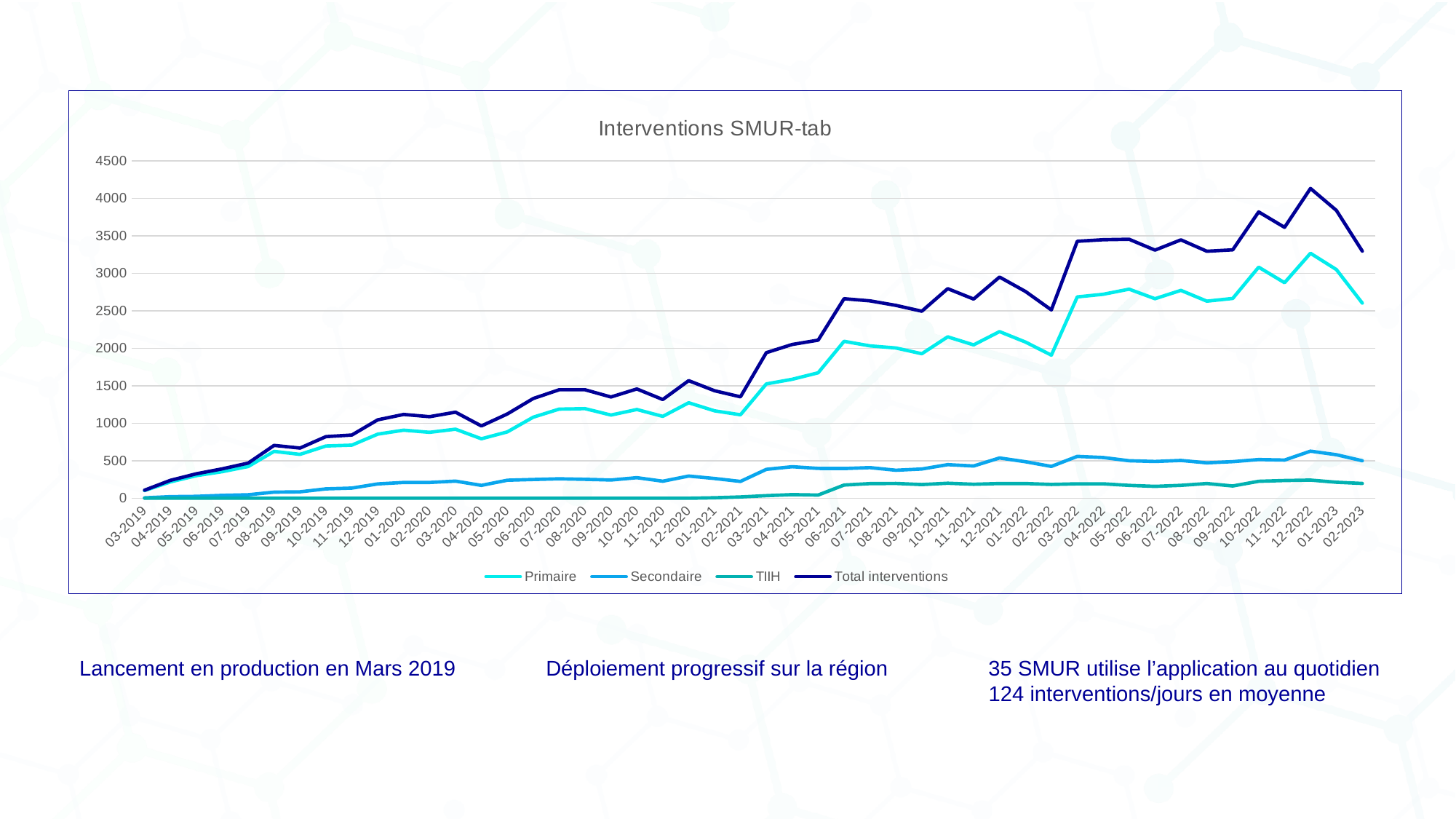
How many months are plotted along the x axis? 48 In which month is the Total interventions series at its lowest? 03-2019 Is the value for Secondaire in 02-2023 greater or less than 1000? less In which month does the Total interventions series reach its highest value? 12-2022 Which series is higher in 12-2022, Primaire or Secondaire? Primaire What is the title of the chart? Interventions SMUR-tab Is the value for Total interventions in 03-2022 greater or less than 3000? greater What kind of chart is shown on the slide? line chart How many series does the legend list? 4 Does the Total interventions series generally rise or fall from 03-2019 to 12-2022? rise Which series are listed in the legend? Primaire, Secondaire, TIIH, Total interventions Is the value for TIIH in 02-2023 greater or less than 500? less